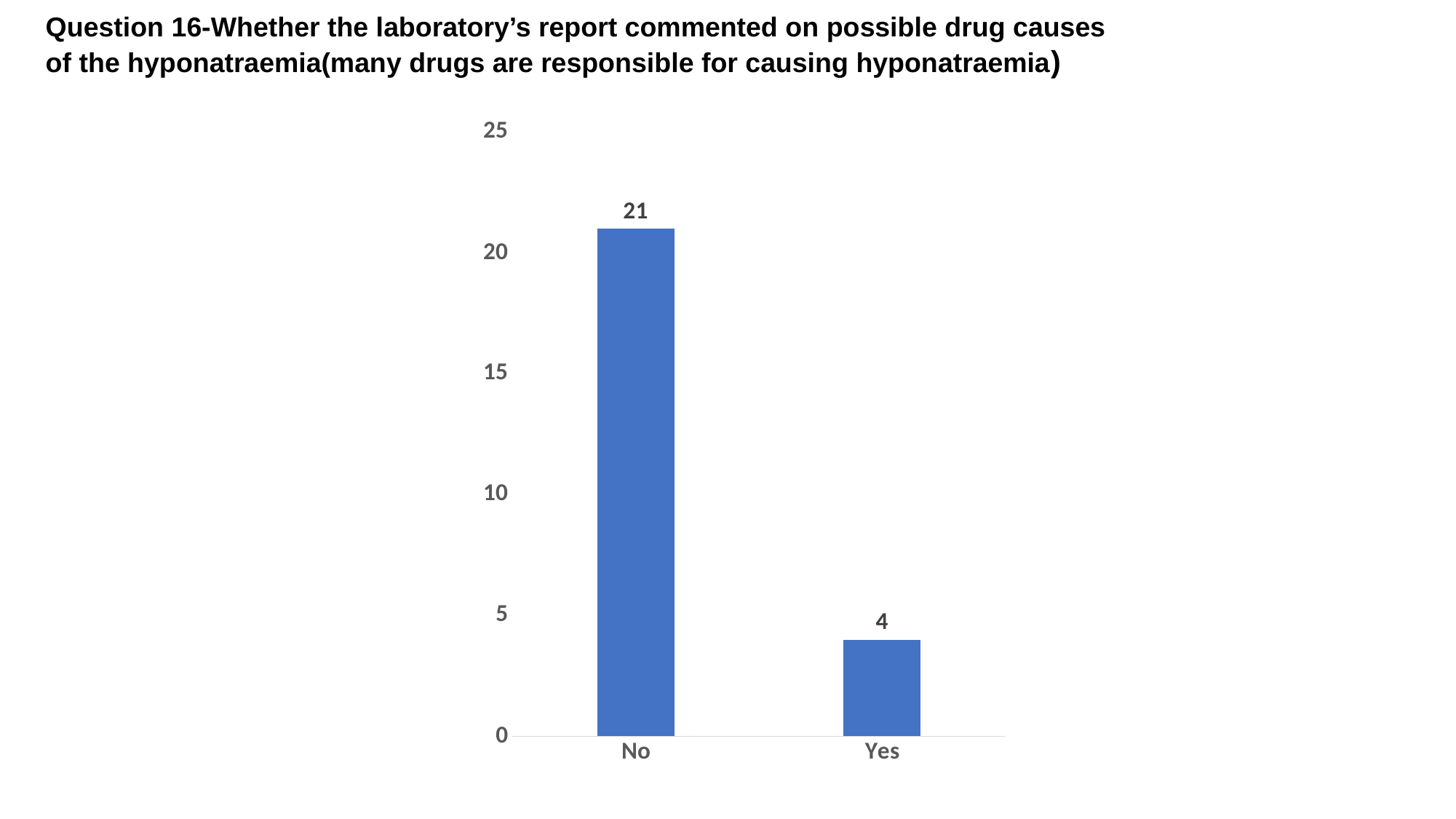
What is the highest value shown on the vertical axis? 25 Is the value for No greater or less than 20? greater What is the value for Yes? 4 Which category has the lowest value? Yes Is the value for Yes greater or less than 5? less What is the total of the values for No and Yes? 25 Which category has the highest value? No How many categories are shown on the x axis? 2 Which is larger, the value for No or the value for Yes? No What is the value for No? 21 What is the difference between the values for No and Yes? 17 What kind of chart is shown on the slide? bar chart